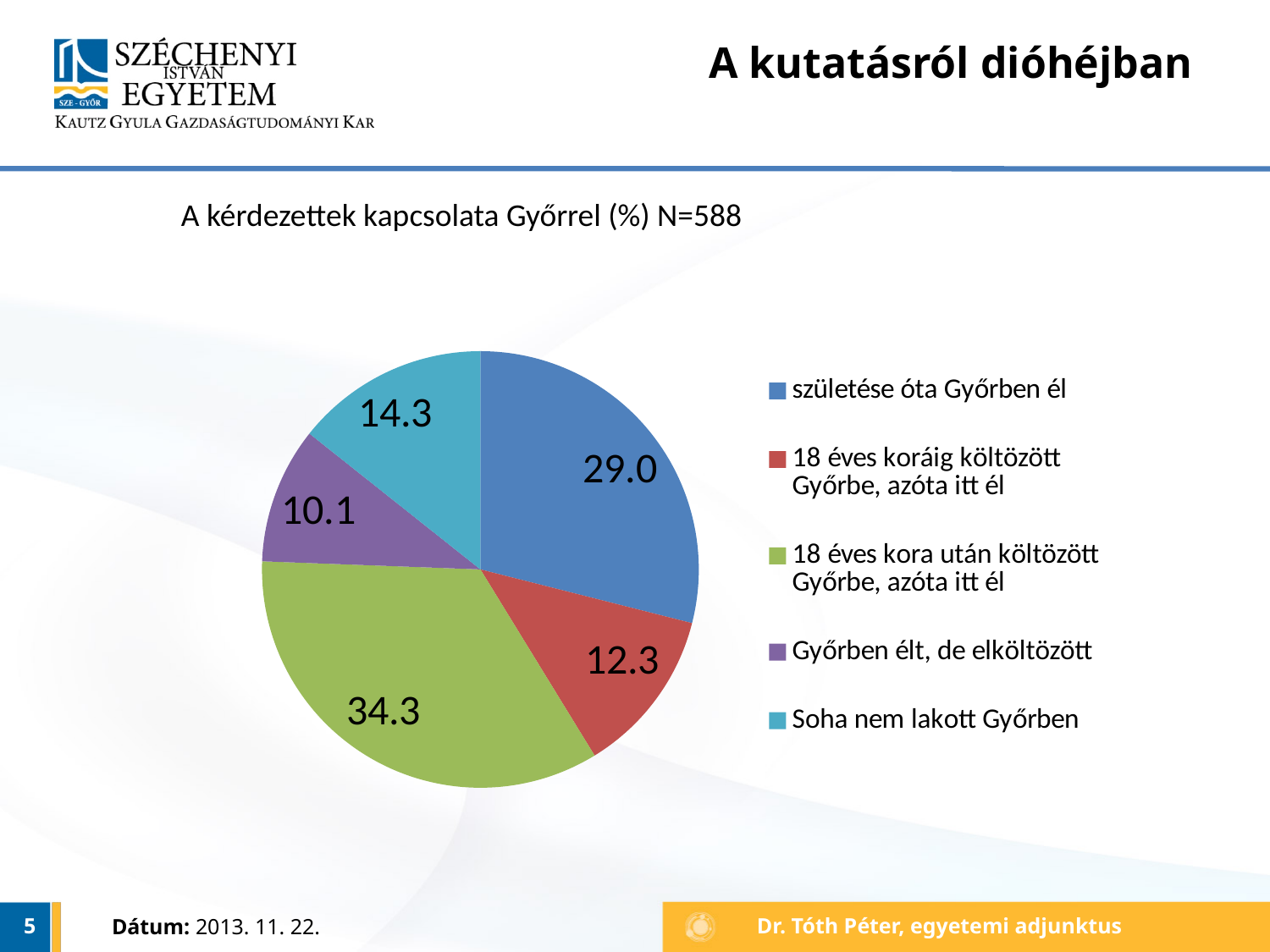
Which category has the largest slice of the pie? 18 éves kora után költözött Győrbe, azóta itt él What is the title of the chart? A kérdezettek kapcsolata Győrrel (%) N=588 Which is larger: the value for "Soha nem lakott Győrben" or the value for "18 éves koráig költözött Győrbe, azóta itt él"? Soha nem lakott Győrben Which category has the smallest slice of the pie? Győrben élt, de elköltözött What kind of chart is shown on the slide? pie chart What colour is the slice for "18 éves koráig költözött Győrbe, azóta itt él"? red How many slices does the pie chart have? 5 What is the value for "Győrben élt, de elköltözött"? 10.1 What is the value for "18 éves kora után költözött Győrbe, azóta itt él"? 34.3 What is the value for "Soha nem lakott Győrben"? 14.3 What is the value for "születése óta Győrben él"? 29.0 What is the difference between the values for "18 éves kora után költözött Győrbe, azóta itt él" and "születése óta Győrben él"? 5.3